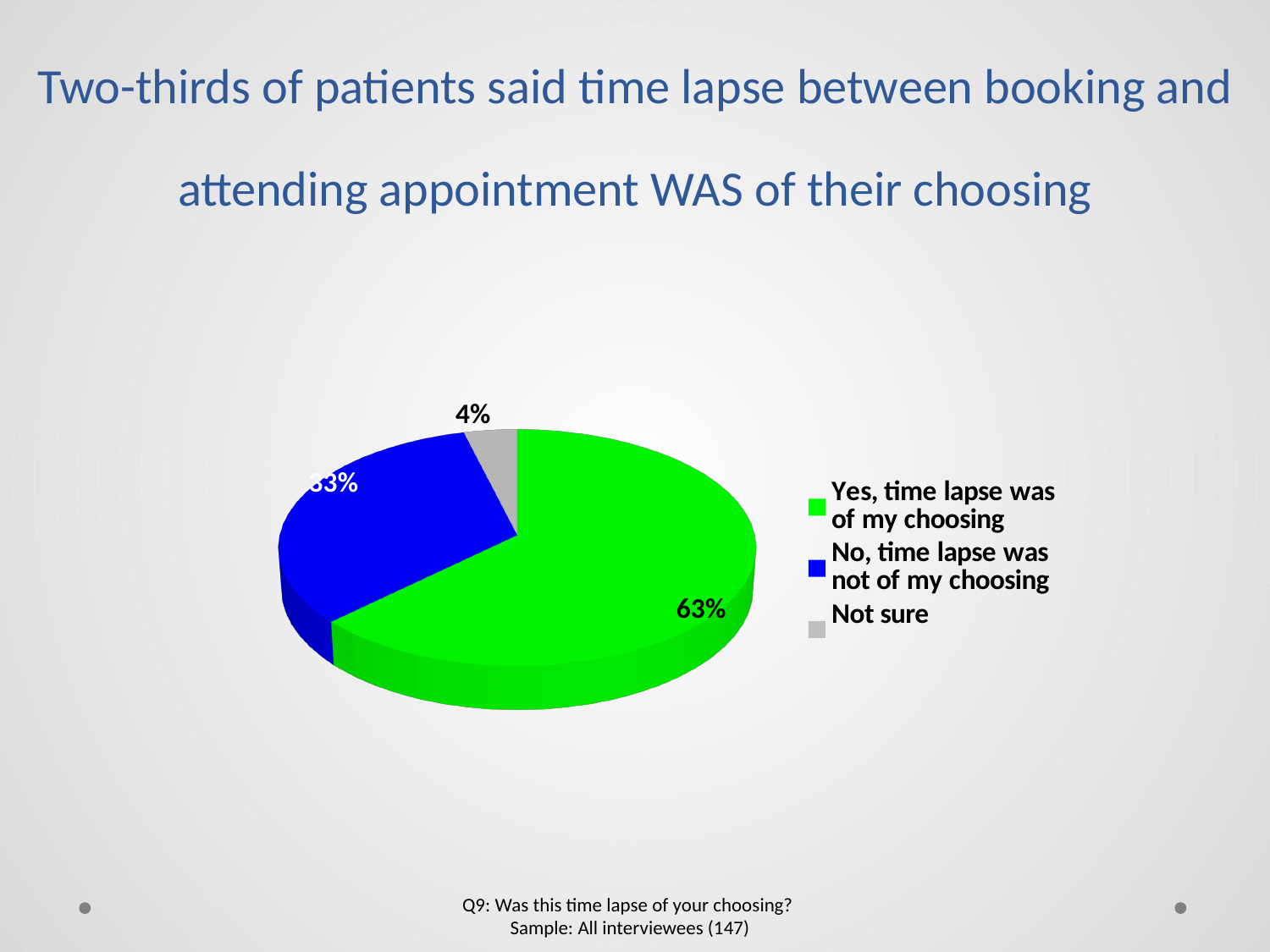
How many entries does the legend list? 3 What is the difference in percentage points between the 'Yes' slice and the 'Not sure' slice? 59 percentage points Which response has the smallest slice of the pie? Not sure What colour is the 'No, time lapse was not of my choosing' slice? Blue Which slice is larger: 'Yes, time lapse was of my choosing' or 'No, time lapse was not of my choosing'? Yes, time lapse was of my choosing What percentage of patients answered 'Not sure'? 4% Which response has the largest slice of the pie? Yes, time lapse was of my choosing How many slices does the pie chart have? 3 What percentage of patients said the time lapse was of their choosing? 63% What share of the pie does the 'Yes, time lapse was of my choosing' slice represent? 63% What kind of chart is shown on the slide? Pie chart What colour is the 'Not sure' slice? Grey